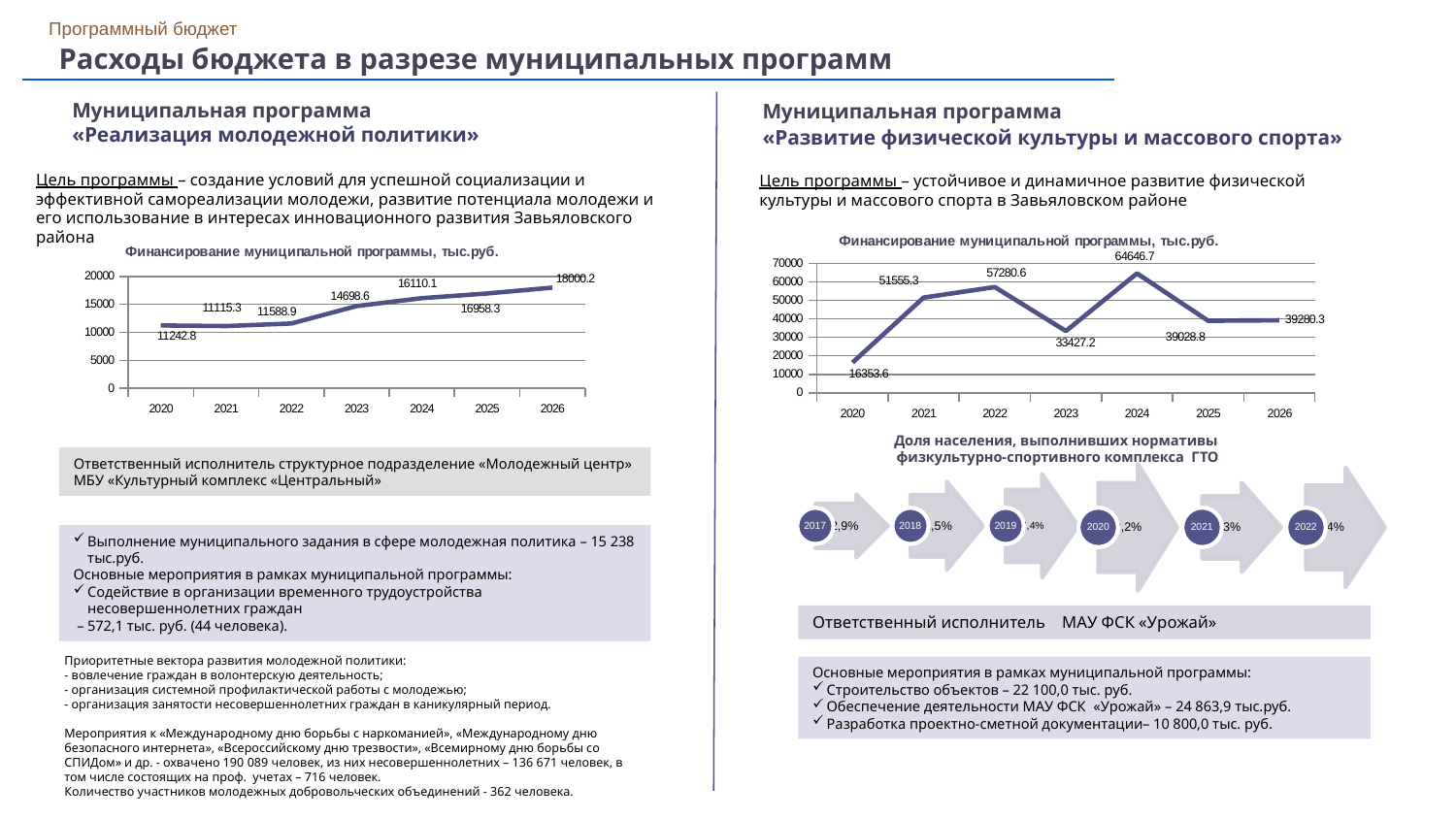
On the right chart (Финансирование муниципальной программы, тыс.руб.), what is the value for 2024? 64646.7 On the left chart, which year has the lowest value? 2021 On the right chart, which is larger: the value for 2022 or the value for 2023? 2022 On the right chart, what is the value for 2020? 16353.6 On the left chart, what is the difference between the values for 2026 and 2020? 6757.4 On the left chart, what is the value for 2026? 18000.2 On the left chart, how many years are plotted? 7 What type of chart is the right chart? line chart On the left chart (Финансирование муниципальной программы, тыс.руб.), what is the value for 2023? 14698.6 On the right chart, which year has the highest value? 2024 On the left chart, do the values generally rise or fall from 2021 to 2026? rise On the right chart, what is the difference between the values for 2024 and 2023? 31219.5